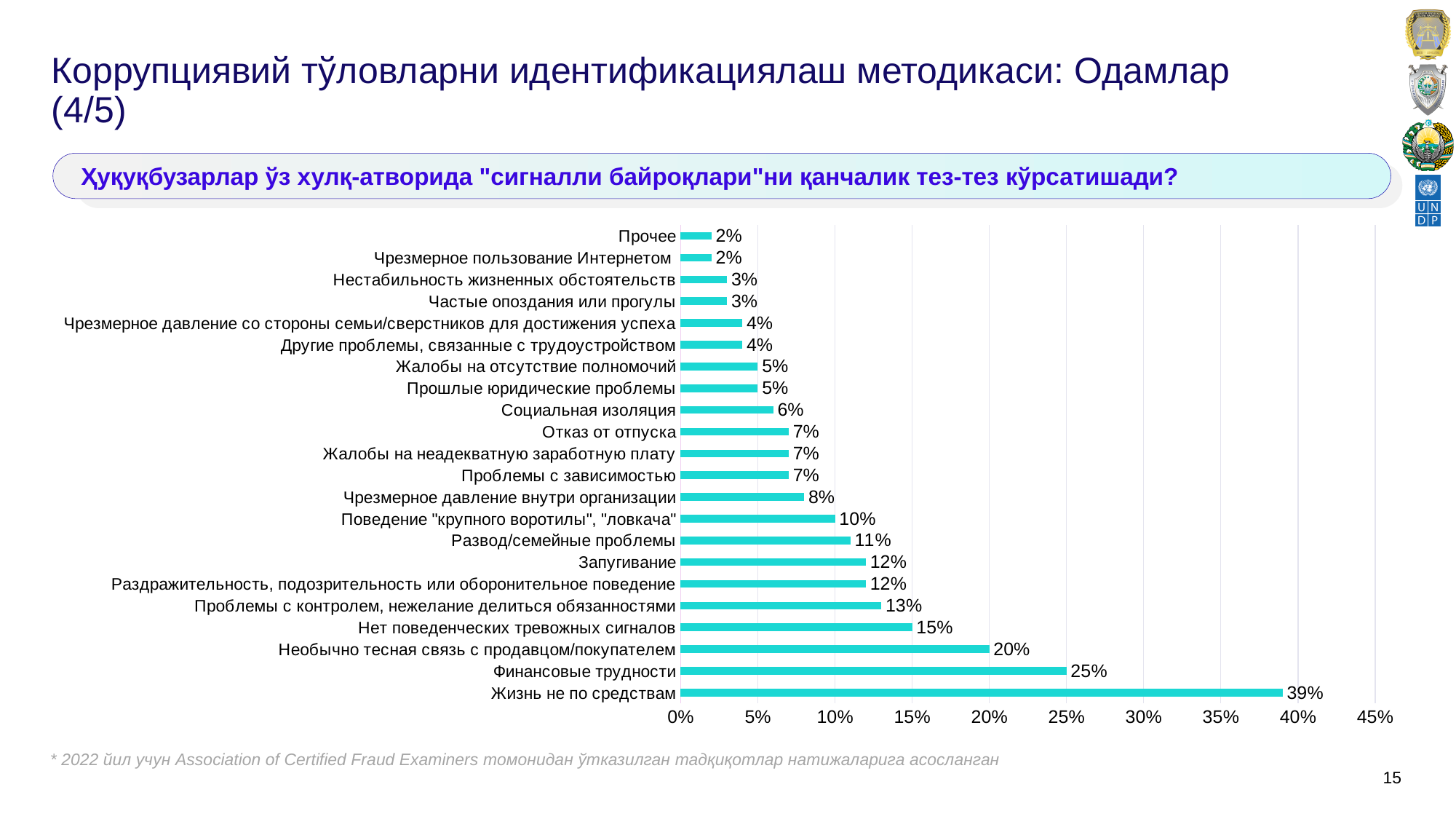
What is the difference between "Необычно тесная связь с продавцом/покупателем" and "Проблемы с контролем, нежелание делиться обязанностями"? 7% What is the difference between "Жизнь не по средствам" and "Финансовые трудности"? 14% What is the value for "Финансовые трудности"? 25% What is the maximum value shown on the horizontal axis? 45% Which category has the highest value? Жизнь не по средствам Is the value for "Финансовые трудности" greater or less than 20%? greater Which is larger: "Запугивание" or "Развод/семейные проблемы"? Запугивание What is the value for "Жизнь не по средствам"? 39% What is the value for "Социальная изоляция"? 6% What is the value for "Нет поведенческих тревожных сигналов"? 15% How many categories are shown in the chart? 22 What kind of chart is shown on the slide? Bar chart